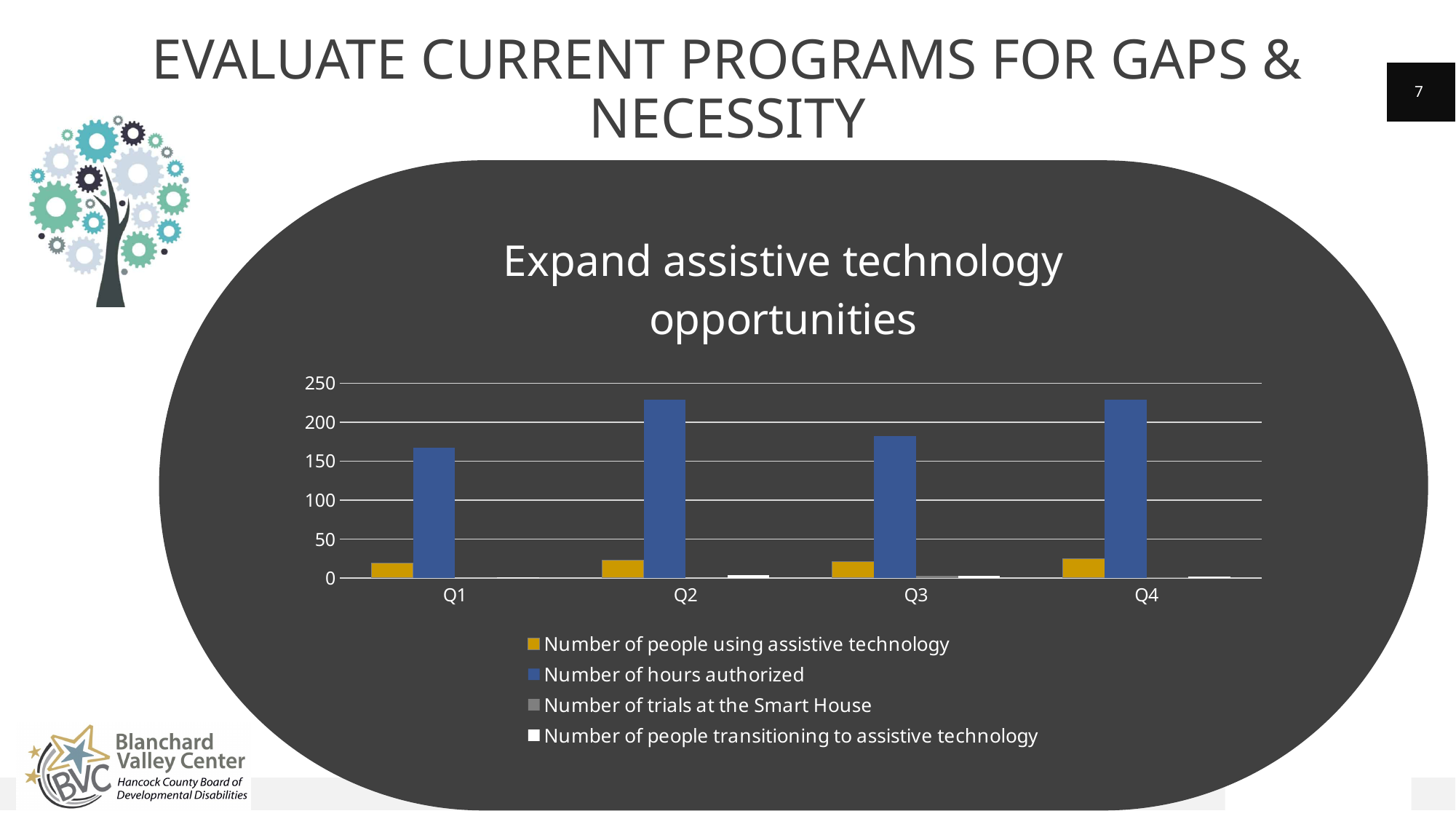
Is the value for Number of people using assistive technology in Q4 greater or less than 50? less How many series does the chart legend list? 4 What is the title of the chart? Expand assistive technology opportunities How many categories are shown on the x axis of the chart? 4 Is the value for Number of hours authorized in Q2 greater or less than 200? greater Which series is shown in blue in the chart? Number of hours authorized Which quarter has the lowest value for Number of hours authorized? Q1 Is the value for Number of hours authorized larger in Q1 or in Q4? Q4 Is the value for Number of hours authorized in Q1 greater or less than 150? greater Is the value for Number of hours authorized larger in Q2 or in Q3? Q2 What type of chart is shown on the slide? bar chart